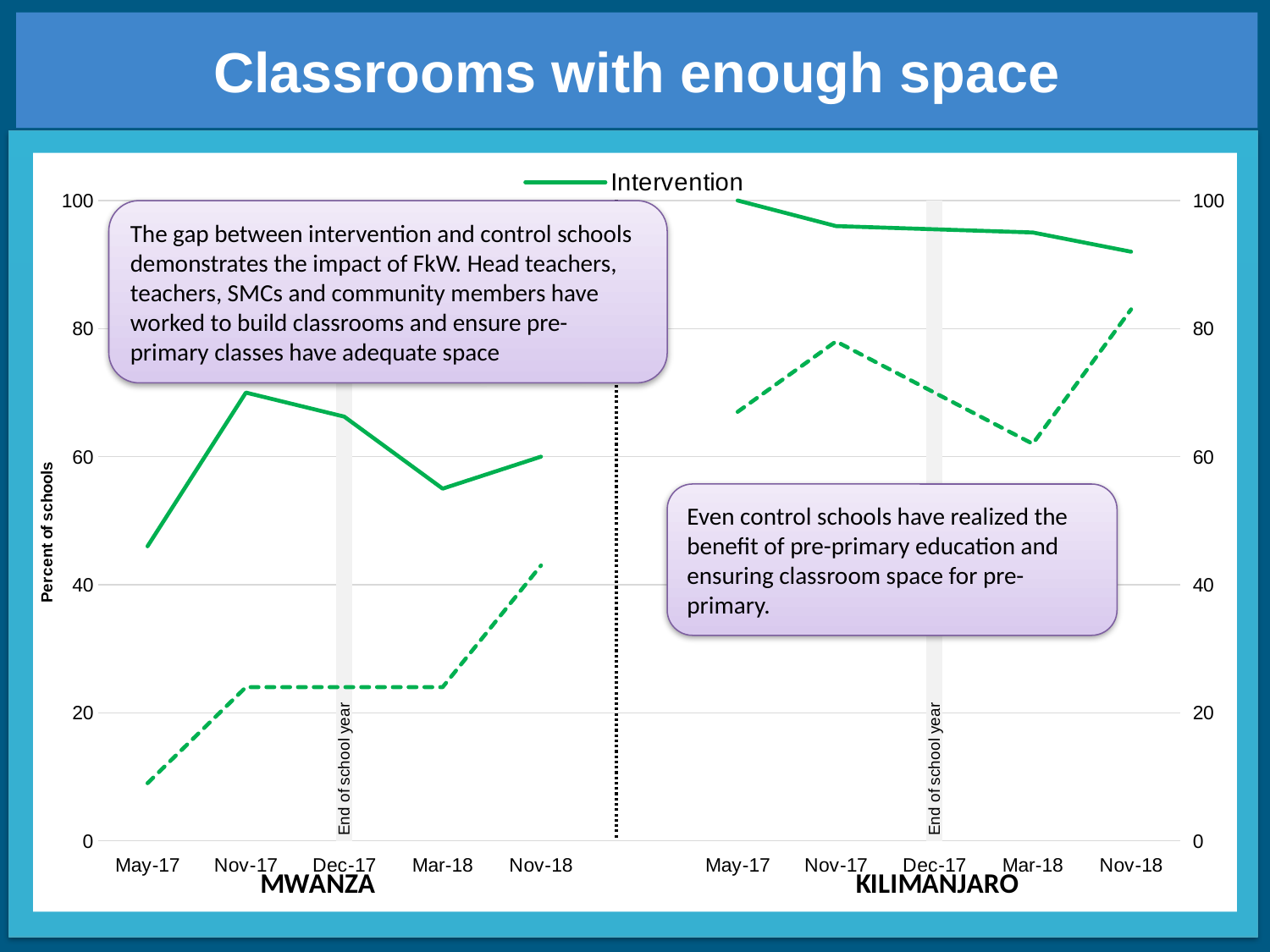
In the KILIMANJARO panel, at which date is the Intervention line lowest? Nov-18 What kind of chart is shown on the slide? line chart In the KILIMANJARO panel, is the Intervention value for Nov-18 greater or less than 80? greater Does the Intervention line in the KILIMANJARO panel rise or fall from May-17 to Nov-18? fall How many series does the legend list? 1 In the MWANZA panel, at which date is the Intervention line lowest? May-17 In the MWANZA panel, at which date is the Intervention line highest? Nov-17 In the MWANZA panel, is the dashed-line value for May-17 greater or less than 20? less How many dates are shown on the x axis of the MWANZA panel? 5 What is the title of the chart? Classrooms with enough space In the MWANZA panel, is the Intervention value for May-17 greater or less than 60? less What is the label on the vertical axis? Percent of schools